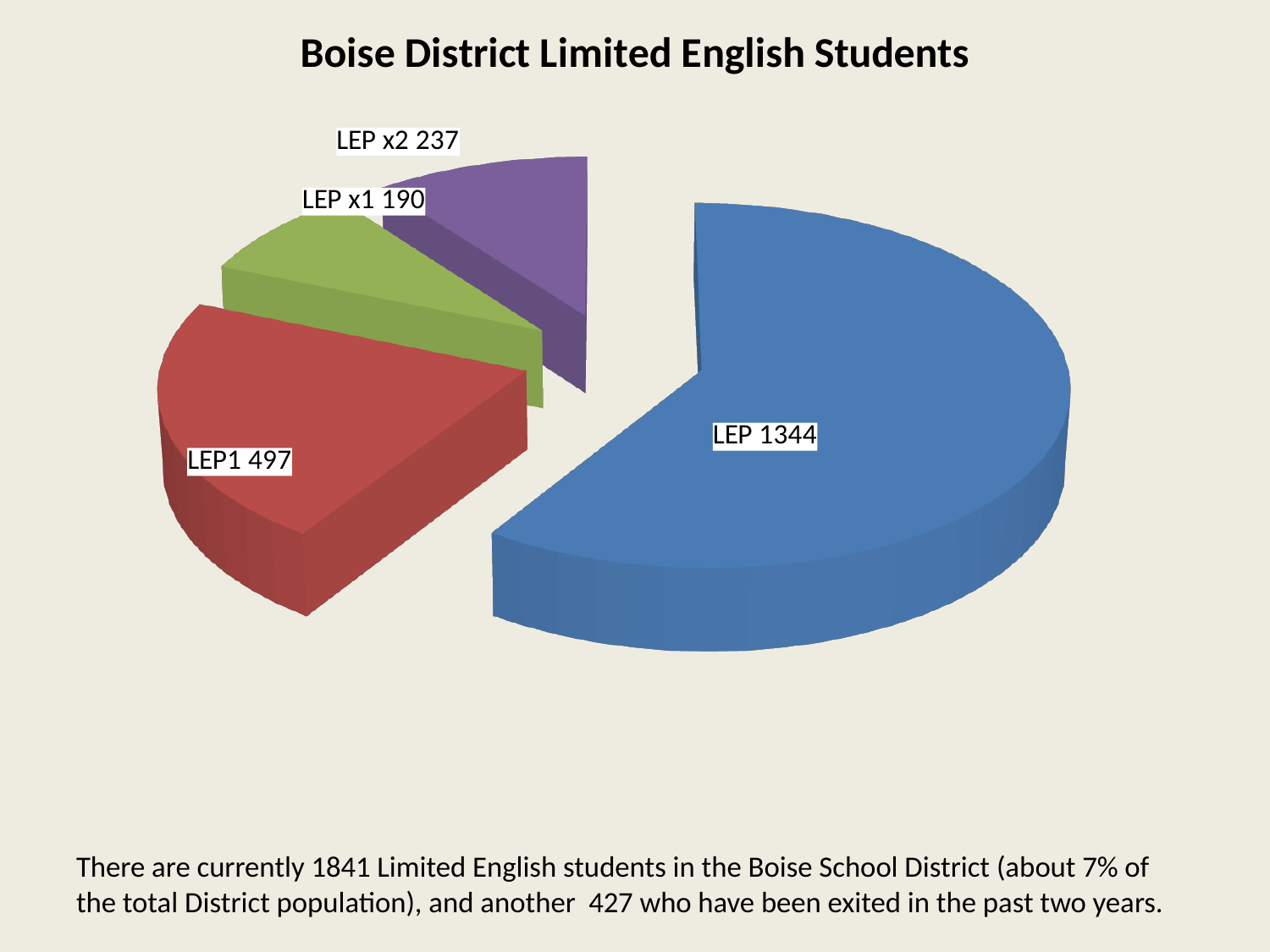
How many slices does the pie chart have? 4 What colour is the LEP1 slice? Red Which category has the largest slice? LEP What type of chart is shown on the slide? Pie chart Which is larger, LEP x2 or LEP x1? LEP x2 What is the value for the LEP x1 slice? 190 Which category has the smallest slice? LEP x1 What is the title of the chart? Boise District Limited English Students What is the difference between the LEP and LEP1 values? 847 What is the value for the LEP1 slice? 497 What is the value for the LEP slice? 1344 What is the value for the LEP x2 slice? 237